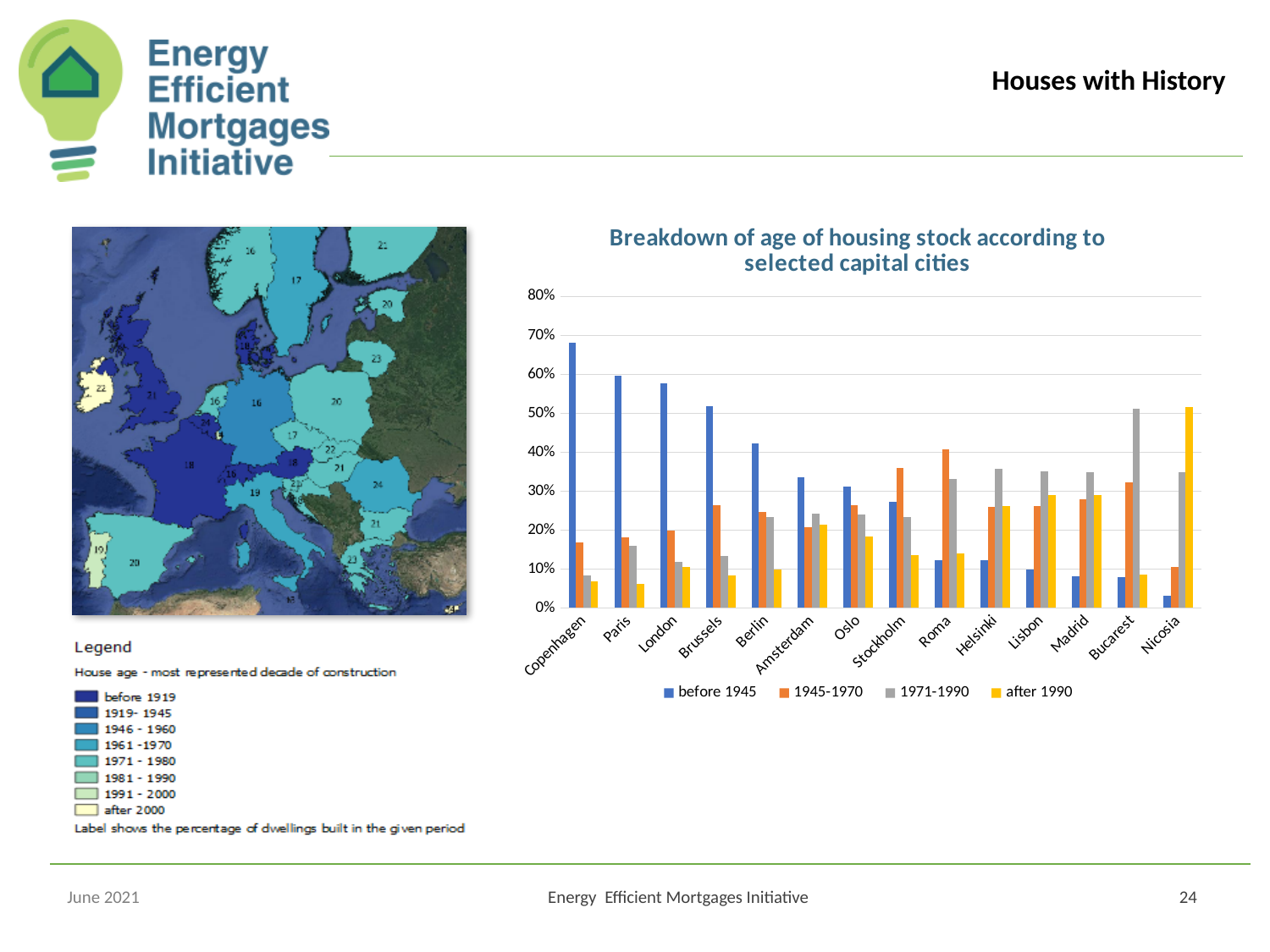
How many capital cities are shown on the x axis of the chart? 14 Which city has the highest value for the '1945-1970' series? Roma Is the 'after 1990' value for Copenhagen greater or less than 10%? less Which city has the highest value for the 'after 1990' series? Nicosia Which city has the highest value for the '1971-1990' series? Bucarest What kind of chart is 'Breakdown of age of housing stock according to selected capital cities'? bar chart How many series does the chart's legend list? 4 Which city has the lowest value for the 'before 1945' series? Nicosia Which is larger: the 'before 1945' value for Copenhagen or the 'before 1945' value for Paris? Copenhagen Is the 'before 1945' value for Copenhagen greater or less than 60%? greater What is the title of the bar chart on the slide? Breakdown of age of housing stock according to selected capital cities